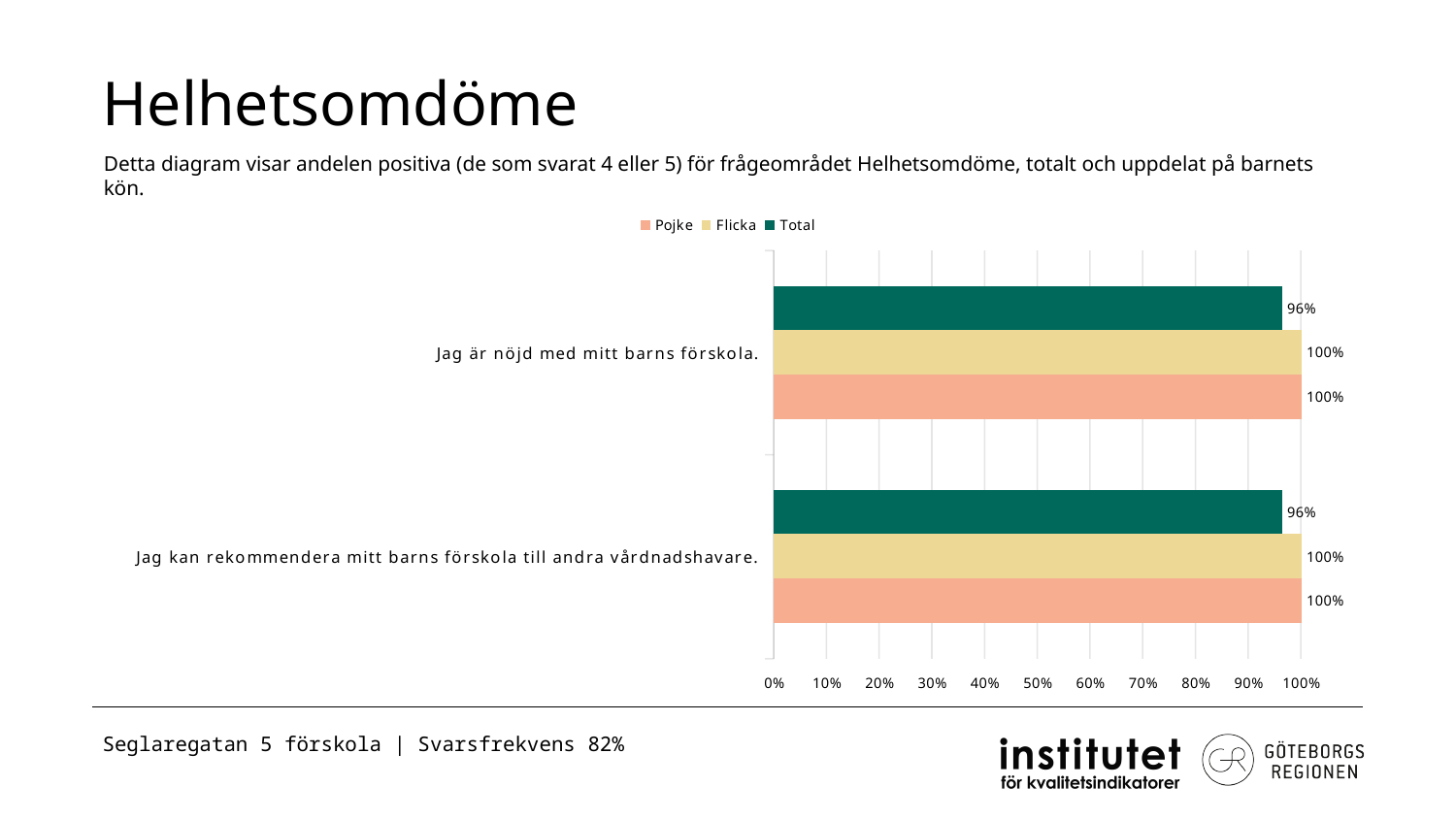
What is the Pojke value for "Jag kan rekommendera mitt barns förskola till andra vårdnadshavare."? 100% How many categories (statements) are shown on the chart? 2 What is the Total value for "Jag kan rekommendera mitt barns förskola till andra vårdnadshavare."? 96% How many series does the legend list? 3 Is the Total value for "Jag är nöjd med mitt barns förskola." greater or less than 90%? greater What is the difference between the Flicka value and the Total value for "Jag är nöjd med mitt barns förskola."? 4% What type of chart is shown on the slide? bar chart What is the Flicka value for "Jag är nöjd med mitt barns förskola."? 100% Which series is shown in green in the legend? Total Which is larger for "Jag kan rekommendera mitt barns förskola till andra vårdnadshavare.": the Pojke value or the Total value? Pojke What is the first entry listed in the chart legend? Pojke What is the Total value for "Jag är nöjd med mitt barns förskola."? 96%